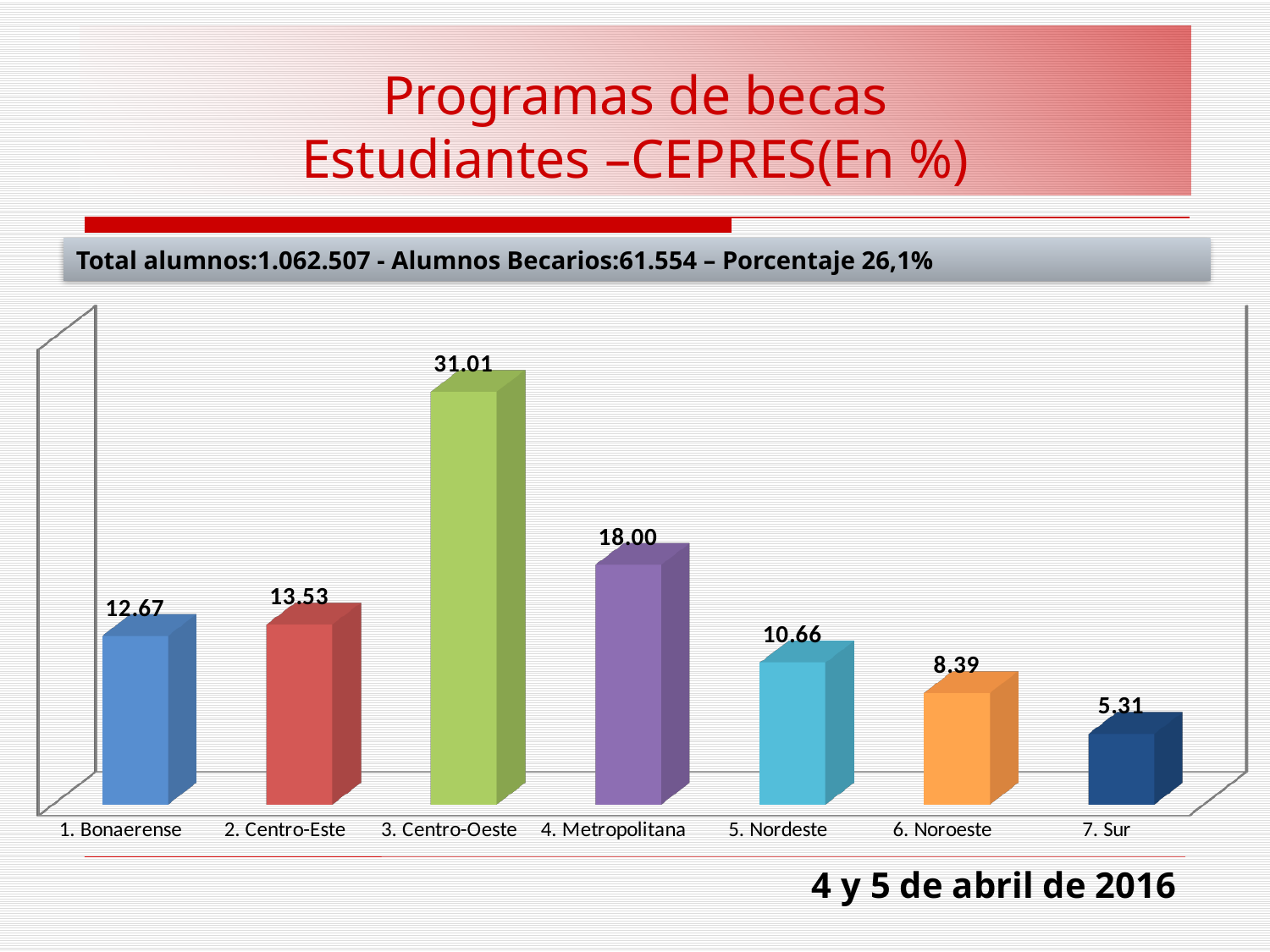
Which category has the lowest value? 7. Sur How many categories are shown on the chart? 7 What is the value for 7. Sur? 5.31 What is the value for 5. Nordeste? 10.66 Which category has the highest value? 3. Centro-Oeste What colour is the bar for 3. Centro-Oeste? Green What is the difference between the values for 3. Centro-Oeste and 4. Metropolitana? 13.01 What is the value for 4. Metropolitana? 18.00 What is the value for 3. Centro-Oeste? 31.01 What kind of chart is shown on the slide? Bar chart What is the difference between the values for 2. Centro-Este and 1. Bonaerense? 0.86 Which is larger, the value for 6. Noroeste or the value for 5. Nordeste? 5. Nordeste